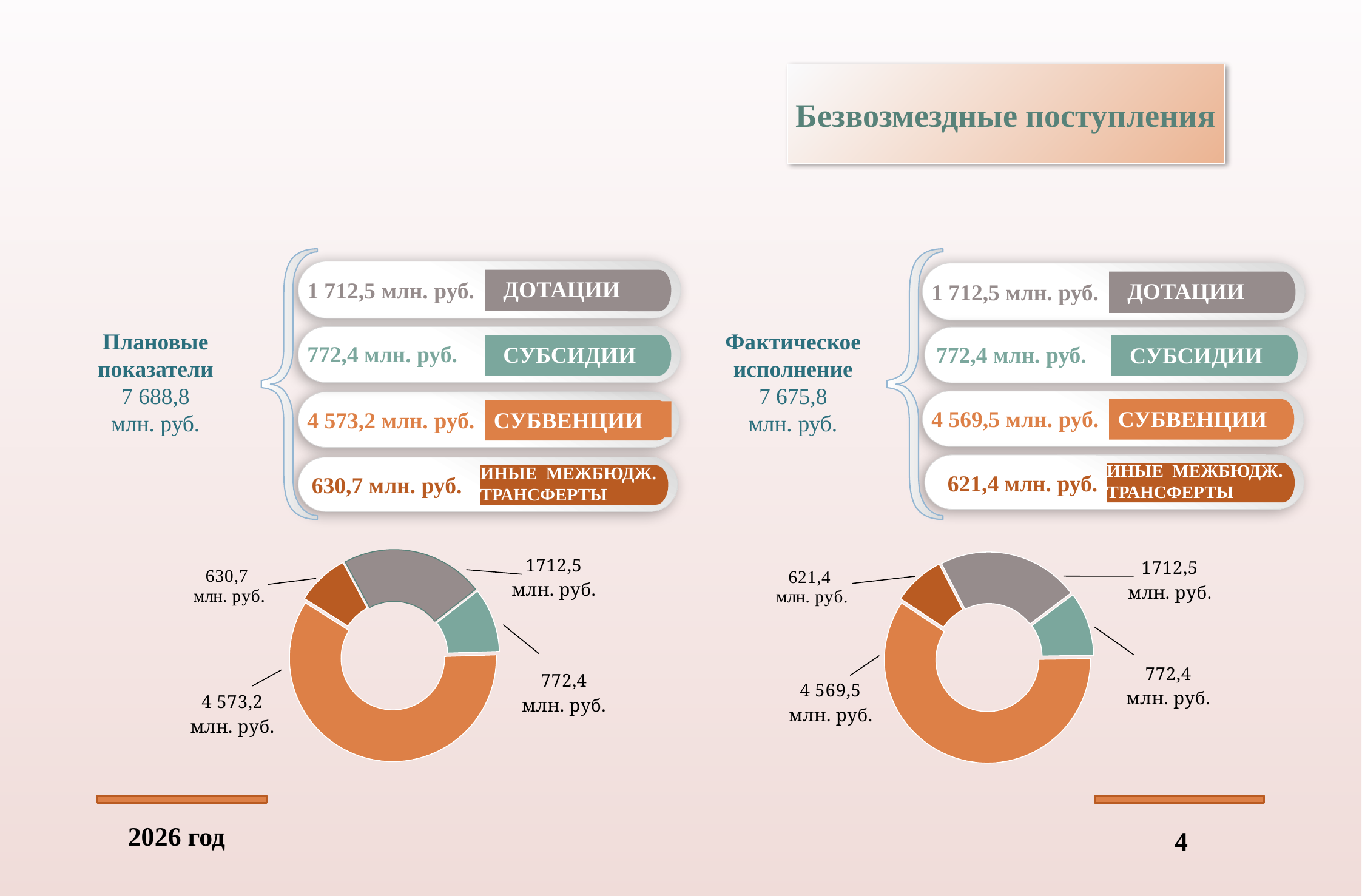
How many slices does the left doughnut chart (Плановые показатели) have? 4 What is the title shown at the top of the slide? Безвозмездные поступления In the left doughnut chart (Плановые показатели), what is the smallest labelled value? 630,7 млн. руб. In the left doughnut chart (Плановые показатели), what value is labelled on the grey slice? 1712,5 млн. руб. What kind of chart is shown on the left side of the slide under "Плановые показатели"? Doughnut (pie) chart In the left doughnut chart (Плановые показатели), what value is labelled on the largest slice? 4 573,2 млн. руб. In the right doughnut chart (Фактическое исполнение), what is the smallest labelled value? 621,4 млн. руб. In the right doughnut chart (Фактическое исполнение), what value is labelled on the largest slice? 4 569,5 млн. руб. How many slices does the right doughnut chart (Фактическое исполнение) have? 4 What is the difference between the largest slice of the left doughnut chart (4 573,2 млн. руб.) and the largest slice of the right doughnut chart (4 569,5 млн. руб.)? 3,7 млн. руб. In the right doughnut chart (Фактическое исполнение), what value is labelled on the teal slice? 772,4 млн. руб. In the left doughnut chart (Плановые показатели), which is larger: the grey slice (1712,5) or the teal slice (772,4)? The grey slice (1712,5 млн. руб.)